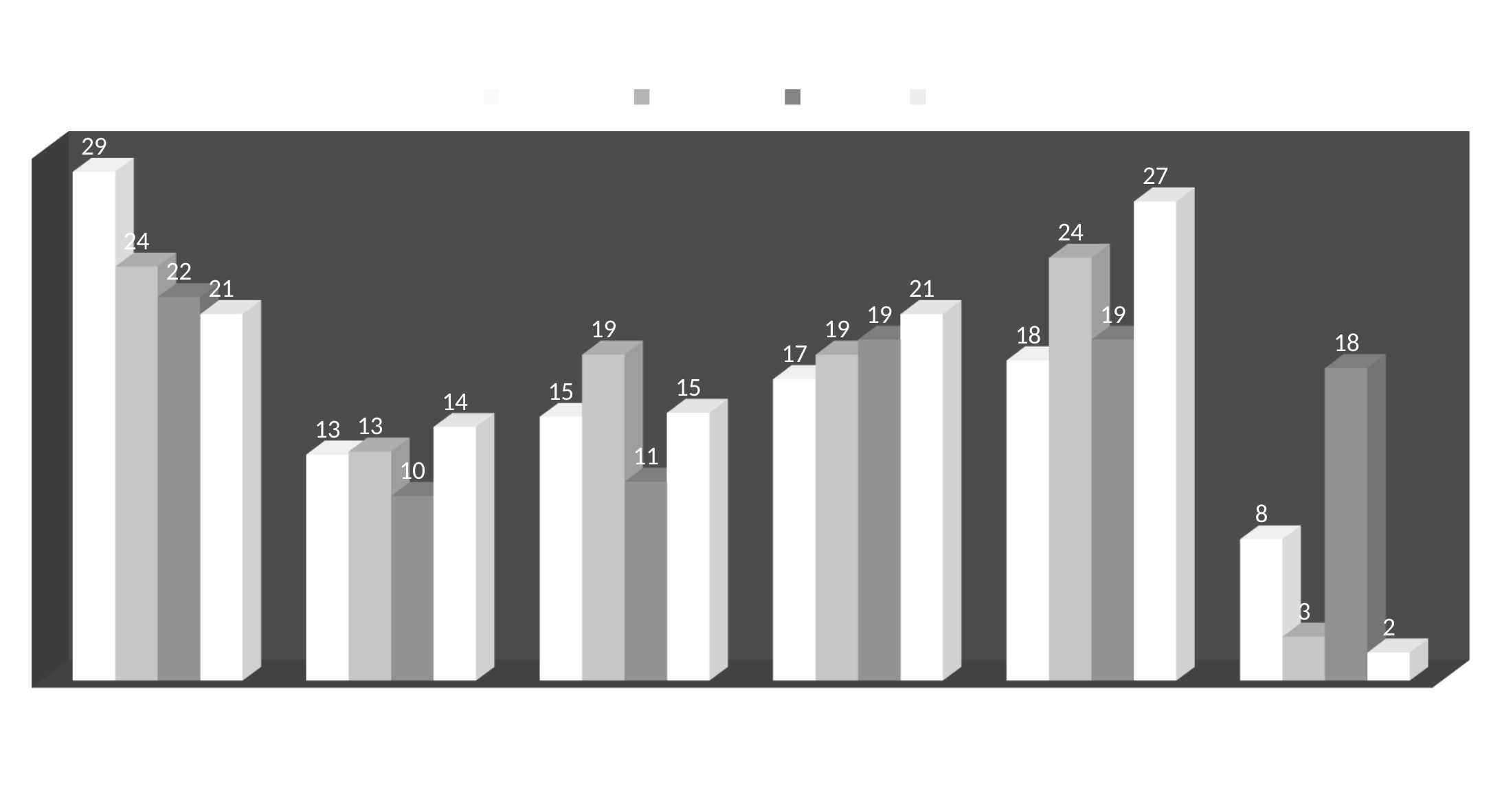
How many series does the legend list? 4 What kind of chart is shown on the slide? bar chart How many groups of bars are plotted along the x axis? 6 What is the value of the third bar in the second group from the left? 10 What is the lowest value shown on the chart? 2 What is the value of the first (leftmost) bar in the leftmost group? 29 In the third group from the left, which is larger: the second bar or the third bar? the second bar (19) What is the value of the last bar in the rightmost group? 2 In the fifth group from the left, what is the difference between the fourth bar (27) and the first bar (18)? 9 What is the highest value shown on the chart? 29 In the fifth group from the left, which bar has the highest value? the fourth bar (27) In the leftmost group, what is the difference between the first bar (29) and the fourth bar (21)? 8